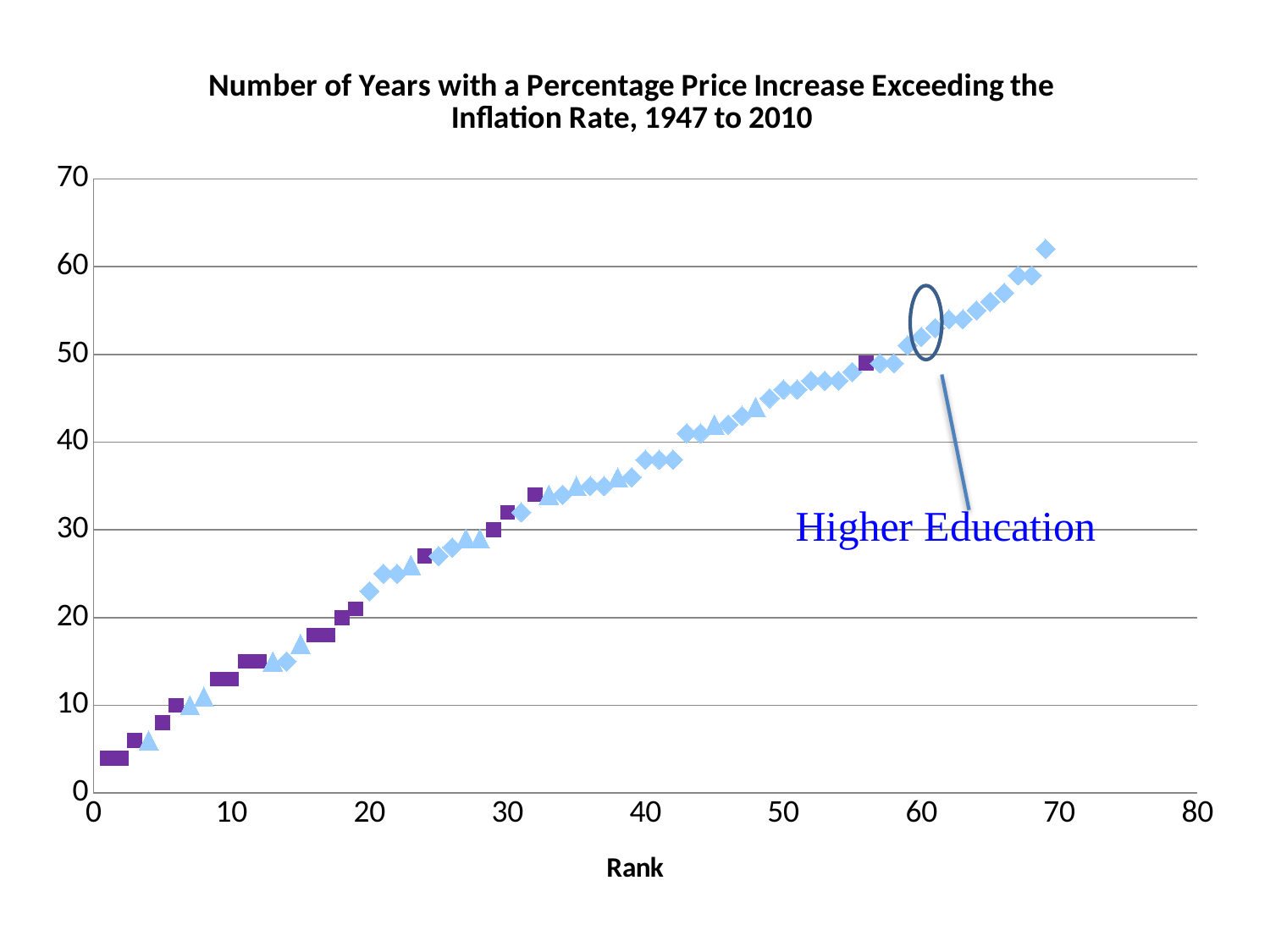
What is the label on the x axis of the chart? Rank Is the value plotted at rank 40 greater or less than 40? less Which has the larger value: the point at rank 60 or the point at rank 30? the point at rank 60 Is the lowest plotted value on the chart greater or less than 10? less What is the title of the chart? Number of Years with a Percentage Price Increase Exceeding the Inflation Rate, 1947 to 2010 Is the value plotted at rank 10 greater or less than 10? greater What kind of chart is shown on the slide? scatter chart Is the value plotted at rank 69 greater or less than the value plotted at rank 56? greater Do the plotted values rise or fall as rank increases along the x axis? rise